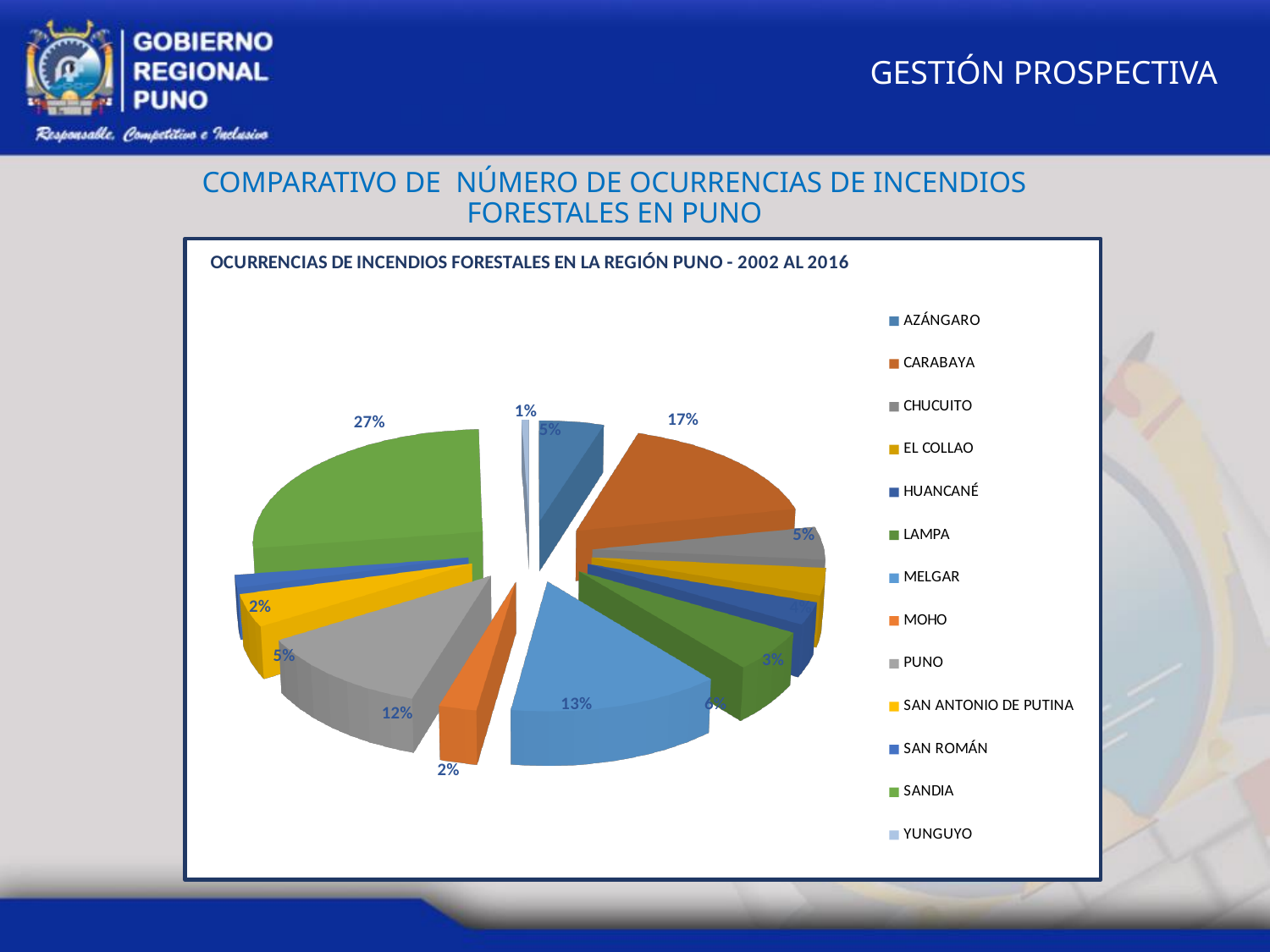
Which province has the smallest share of forest fire occurrences? YUNGUYO What percentage is shown for PUNO? 12% What percentage is shown for MELGAR? 13% By how many percentage points does SANDIA's share exceed CARABAYA's? 10 percentage points What percentage is shown for MOHO? 2% Which has a larger share, MELGAR or PUNO? MELGAR How many provinces are listed in the chart's legend? 13 What percentage is shown for CARABAYA? 17% What share of forest fire occurrences corresponds to SANDIA? 27% What is the title of the chart? OCURRENCIAS DE INCENDIOS FORESTALES EN LA REGIÓN PUNO - 2002 AL 2016 Which province has the largest share of forest fire occurrences? SANDIA What kind of chart is shown on the slide? Pie chart